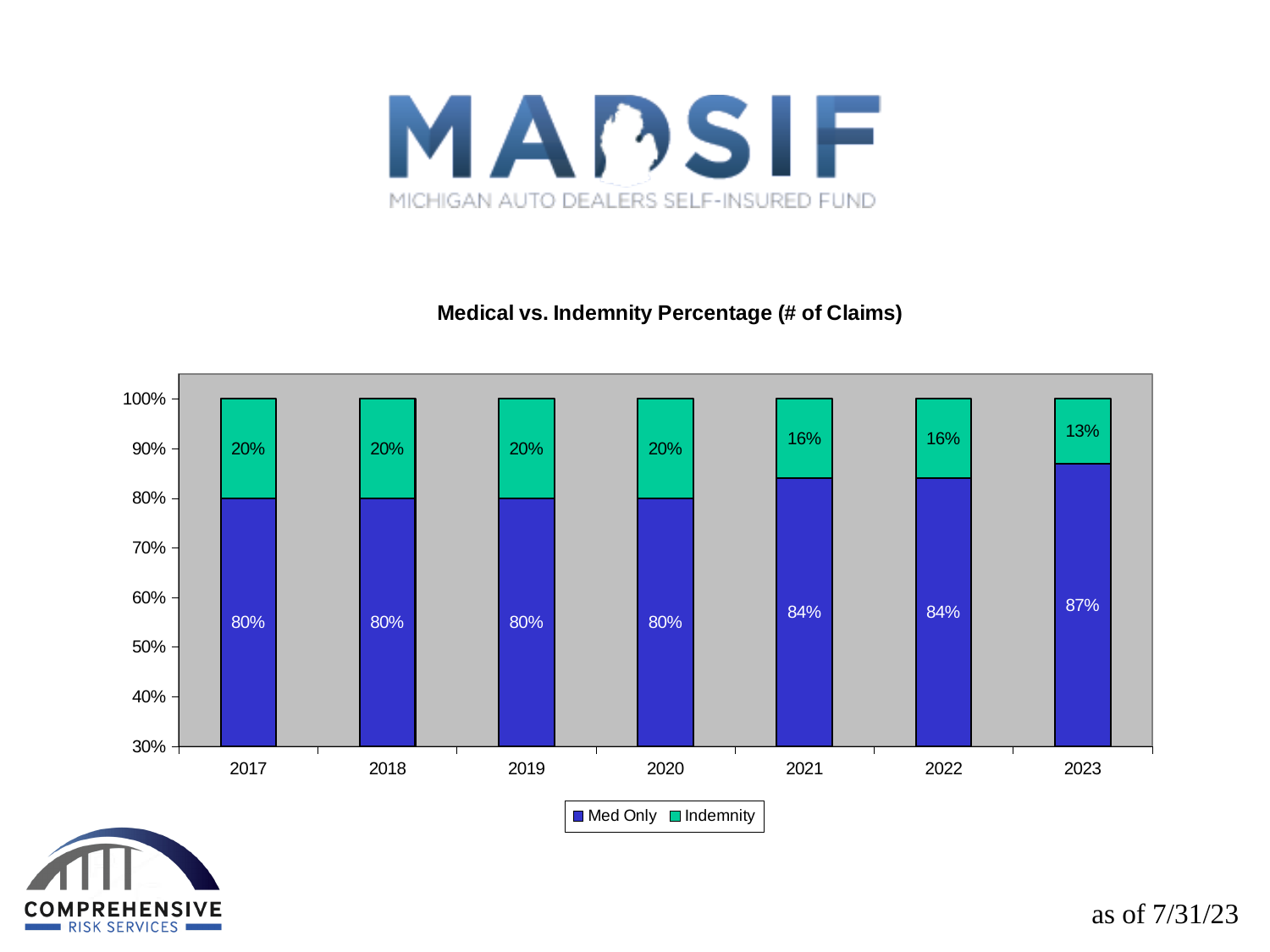
Is the Indemnity percentage larger in 2020 or in 2022? 2020 What is the Med Only percentage for 2021? 84% What kind of chart is shown? Stacked bar chart What is the Indemnity percentage for 2023? 13% How many years are shown on the x axis? 7 Does the Med Only percentage rise or fall from 2017 to 2023? Rise What is the difference between the Med Only percentage in 2023 and in 2017? 7% Which year has the lowest Indemnity percentage? 2023 Which year has the highest Med Only percentage? 2023 What is the Indemnity percentage for 2018? 20% What is the title of the chart? Medical vs. Indemnity Percentage (# of Claims) How many series does the legend list? 2